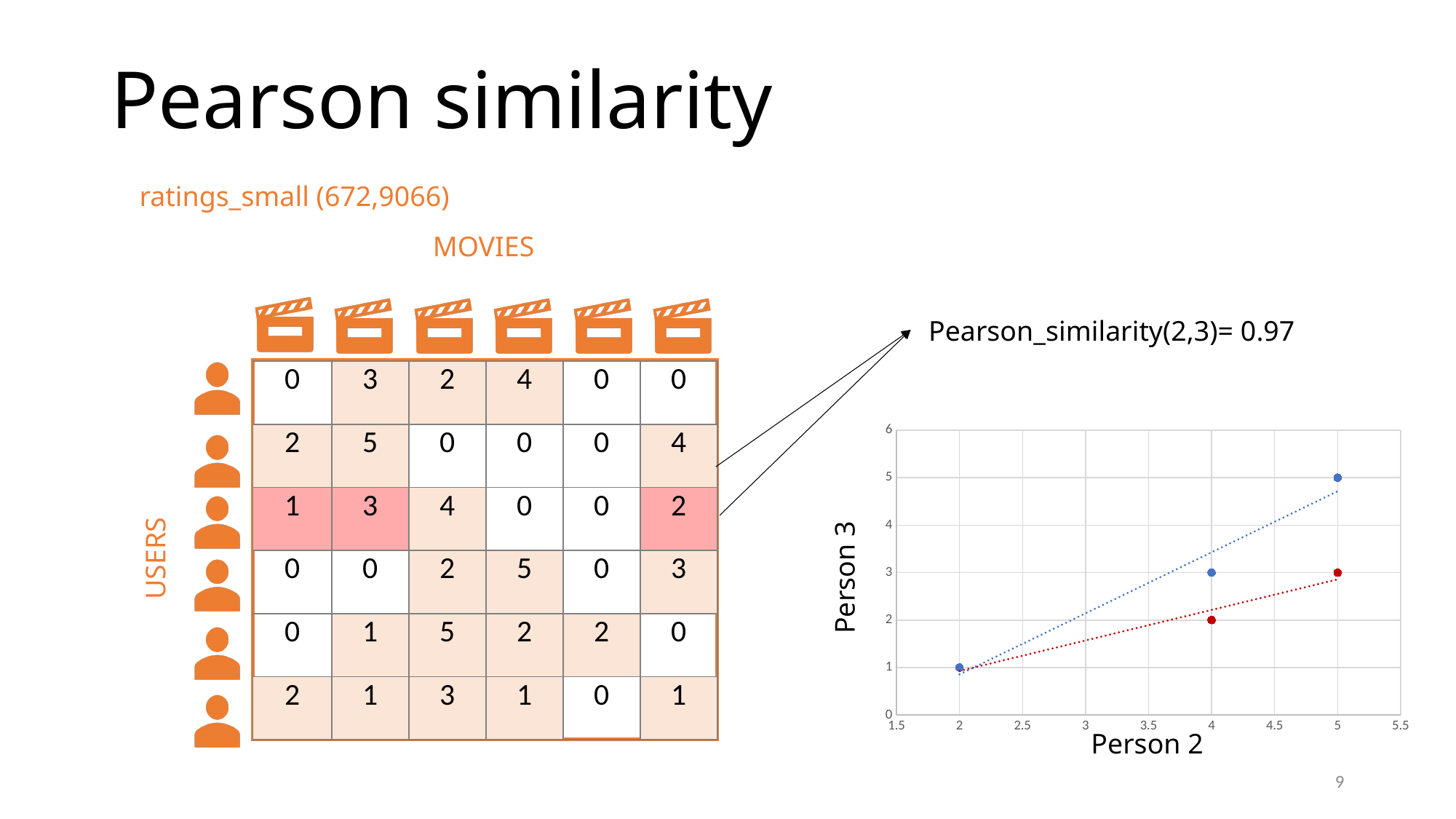
What is the label of the x axis of the scatter chart? Person 2 How many red points are plotted in the scatter chart? 3 In the scatter chart, what is the Person 3 value of the red point at Person 2 = 4? 2 In the scatter chart, what is the Person 3 value of the blue point at Person 2 = 5? 5 In the scatter chart, is the Person 3 value of the red point at Person 2 = 5 greater or less than 4? less What is the label of the y axis of the scatter chart? Person 3 In the scatter chart, what is the difference in Person 3 value between the blue and red points at Person 2 = 5? 2 In the scatter chart, what is the Person 3 value of the blue point at Person 2 = 4? 3 What kind of chart is shown on the right of the slide? scatter chart In the scatter chart, at Person 2 = 5, which point has the higher Person 3 value, the blue or the red? blue In the scatter chart, do the blue points rise or fall as Person 2 increases? rise How many blue points are plotted in the scatter chart? 3